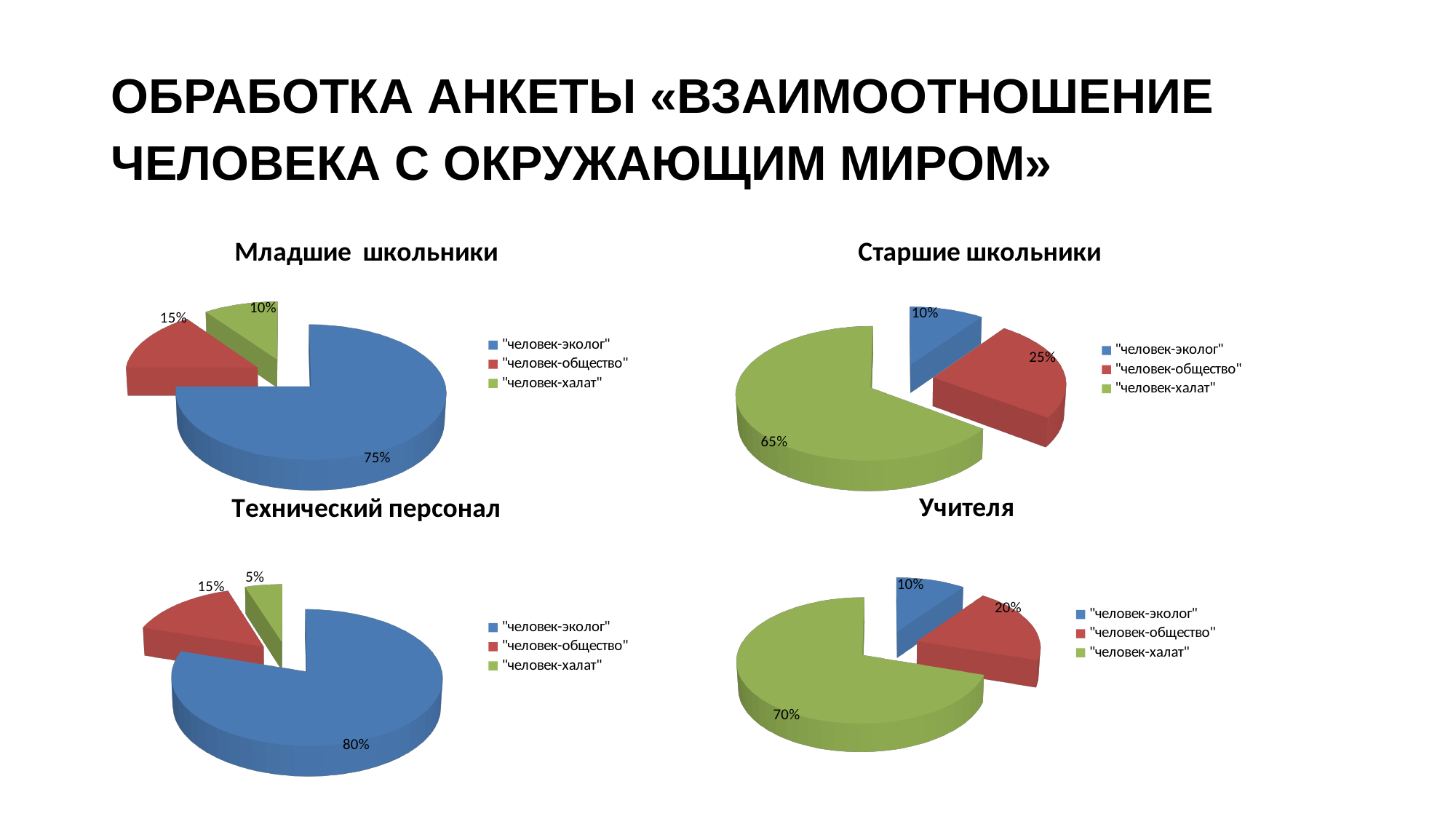
In the "Младшие школьники" chart, which is larger: "человек-общество" or "человек-халат"? "человек-общество" In the "Технический персонал" chart, which category has the smallest slice? "человек-халат" In the "Учителя" chart, what share does "человек-общество" have? 20% In the "Младшие школьники" chart, what share does "человек-эколог" have? 75% How many entries does the legend of the "Старшие школьники" chart list? 3 In the "Старшие школьники" chart, what share does "человек-халат" have? 65% What kind of chart is the "Технический персонал" chart? Pie chart In the "Технический персонал" chart, what share does "человек-халат" have? 5% In the "Младшие школьники" chart, which colour represents "человек-халат"? Green In the "Учителя" chart, which category has the largest slice? "человек-халат" In the "Старшие школьники" chart, what is the difference between the shares of "человек-халат" and "человек-общество"? 40% How many slices does the "Учителя" chart have? 3